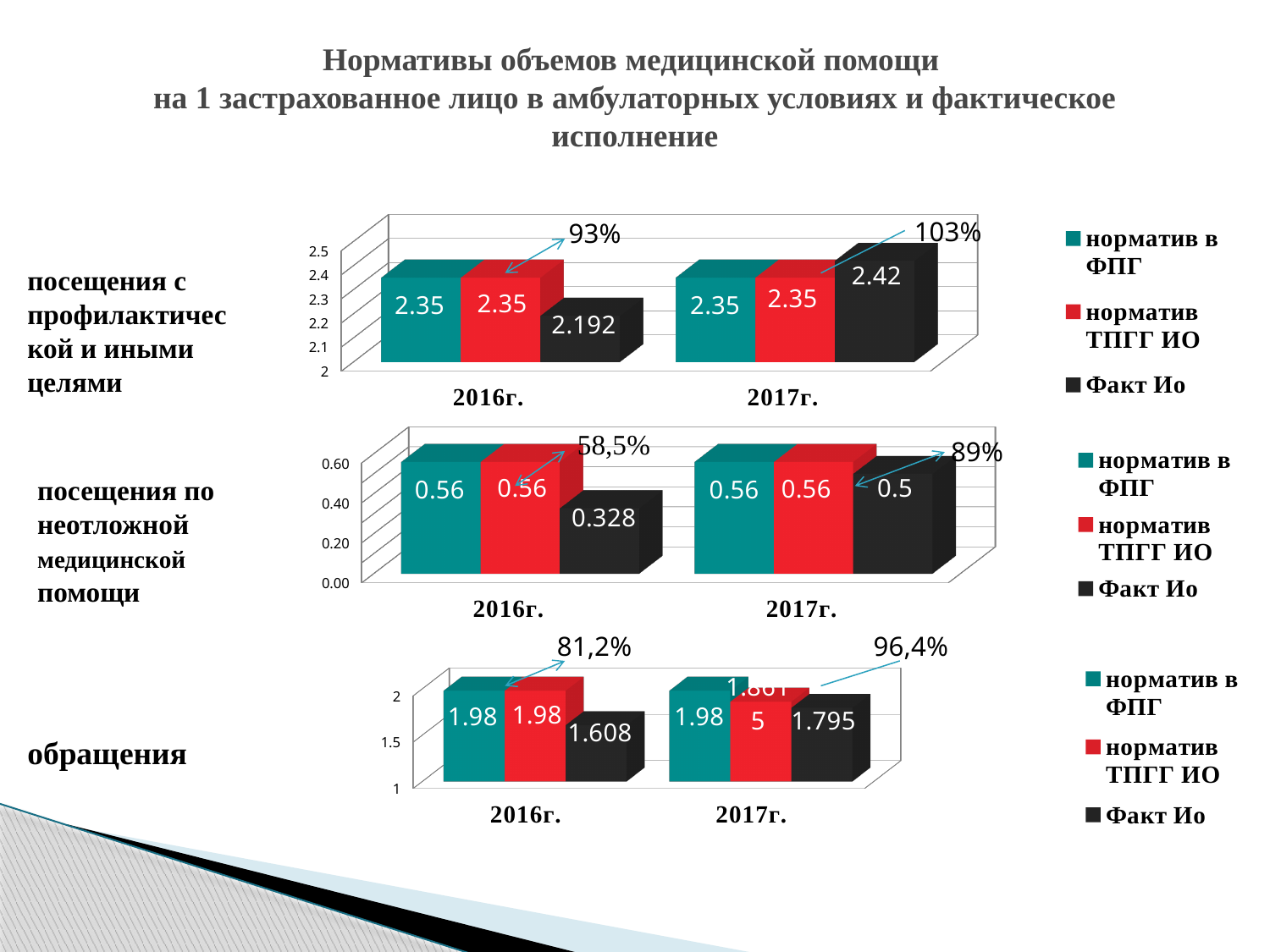
On the middle chart (посещения по неотложной медицинской помощи), what is the difference between норматив в ФПГ and Факт Ио for 2016г.? 0.232 On the bottom chart (обращения), what is the value of Факт Ио for 2016г.? 1.608 How many series does the legend of the top chart list? 3 On the middle chart (посещения по неотложной медицинской помощи), what is the value of Факт Ио for 2016г.? 0.328 On the top chart (посещения с профилактической и иными целями), what is the value of Факт Ио for 2016г.? 2.192 On the top chart (посещения с профилактической и иными целями), what is the value of норматив в ФПГ for 2016г.? 2.35 What kind of chart is the bottom chart (обращения)? Bar chart On the bottom chart (обращения), what is the value of Факт Ио for 2017г.? 1.795 On the bottom chart (обращения), what is the difference between норматив в ФПГ and Факт Ио for 2016г.? 0.372 On the middle chart (посещения по неотложной медицинской помощи), what is the value of Факт Ио for 2017г.? 0.5 On the top chart (посещения с профилактической и иными целями), what is the value of Факт Ио for 2017г.? 2.42 On the top chart (посещения с профилактической и иными целями), which is larger for 2017г.: норматив ТПГГ ИО or Факт Ио? Факт Ио